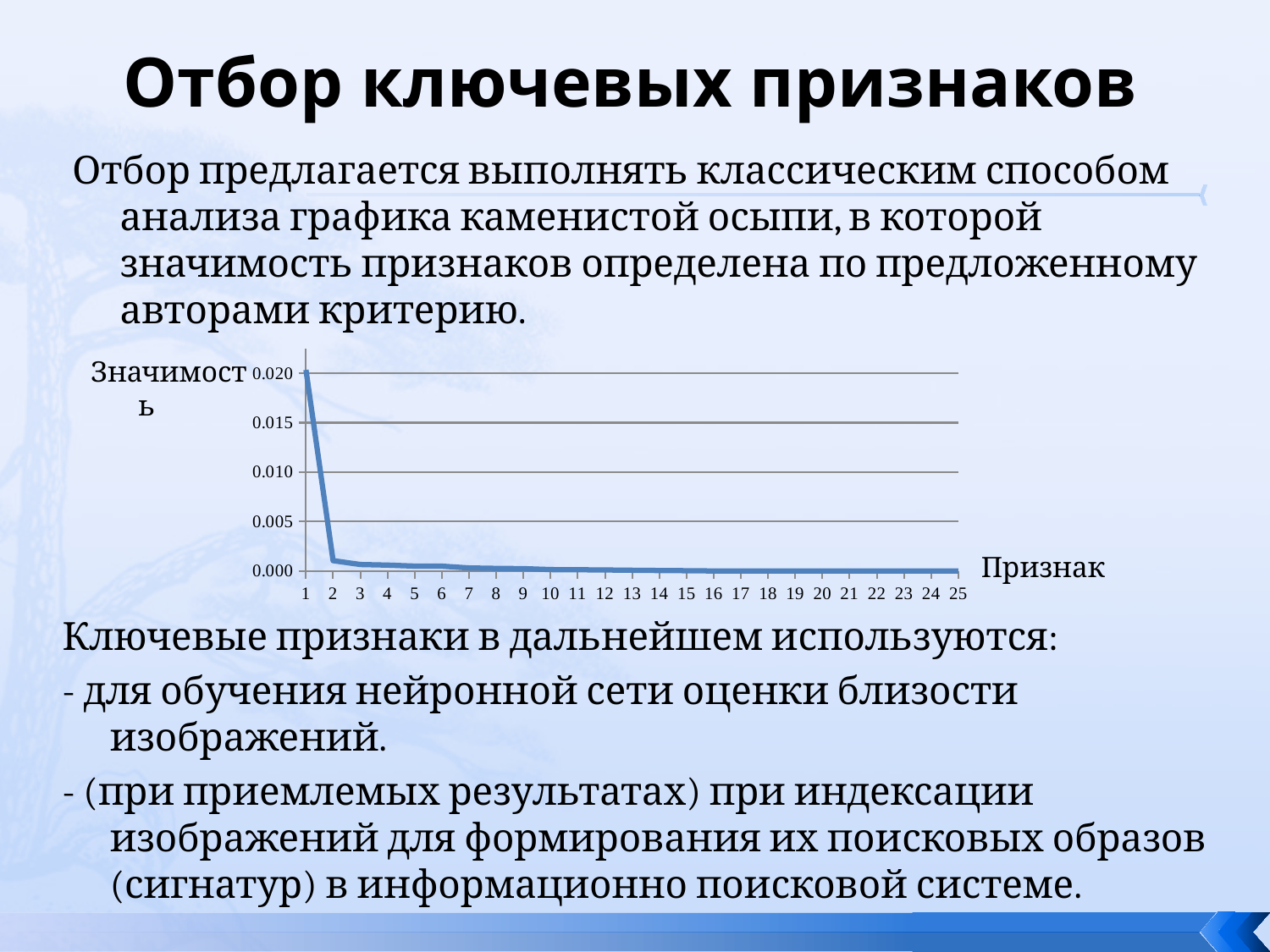
Is the value for признак 2 greater or less than 0.005? less What is the label of the horizontal axis of the chart? Признак Is the value for признак 10 greater or less than 0.005? less What is the label of the vertical axis of the chart? Значимость How many points (признаки) are plotted along the x axis? 25 Which has the larger value, признак 1 or признак 2? признак 1 Do the values rise or fall as the признак number increases along the x axis? fall What kind of chart is shown on the slide? line chart Which признак has the highest значимость? 1 What is the highest tick value shown on the vertical axis? 0.020 Is the value for признак 1 greater or less than 0.015? greater